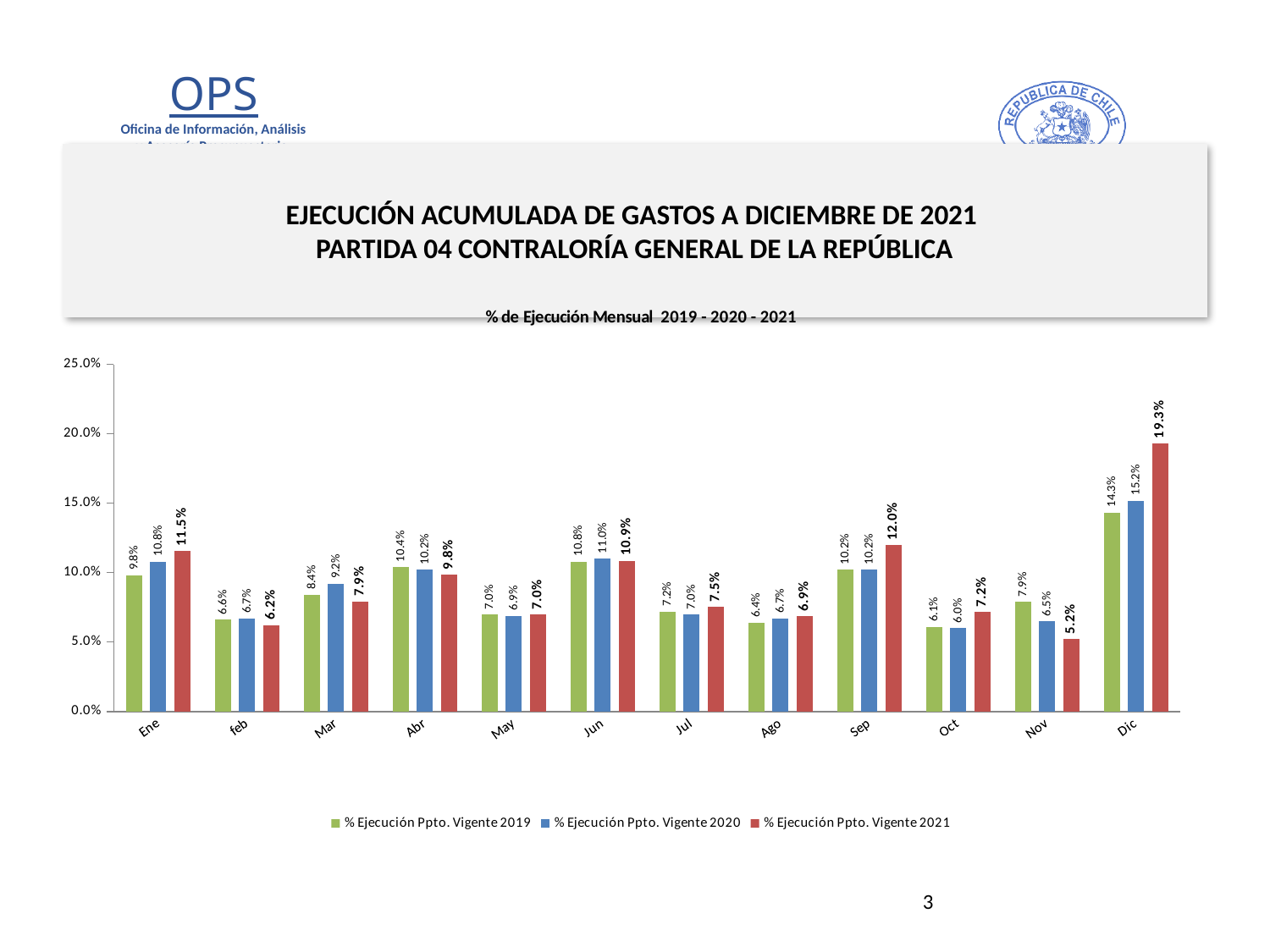
What is the value for Sep in the % Ejecución Ppto. Vigente 2020 series? 10.2% How many series does the legend list? 3 Which is larger for Nov: the 2019 value or the 2021 value? 2019 value What is the value for Dic in the % Ejecución Ppto. Vigente 2021 series? 19.3% What is the difference between the 2021 and 2019 values for Dic? 5.0% What kind of chart is shown on the slide? Bar chart Which month has the highest value in the % Ejecución Ppto. Vigente 2021 series? Dic How many months are shown on the x axis? 12 What is the value for Ene in the % Ejecución Ppto. Vigente 2019 series? 9.8% Is the value for Dic in the 2020 series greater or less than 15.0%? greater What is the title of the chart? % de Ejecución Mensual 2019 - 2020 - 2021 Which month has the lowest value in the % Ejecución Ppto. Vigente 2021 series? Nov